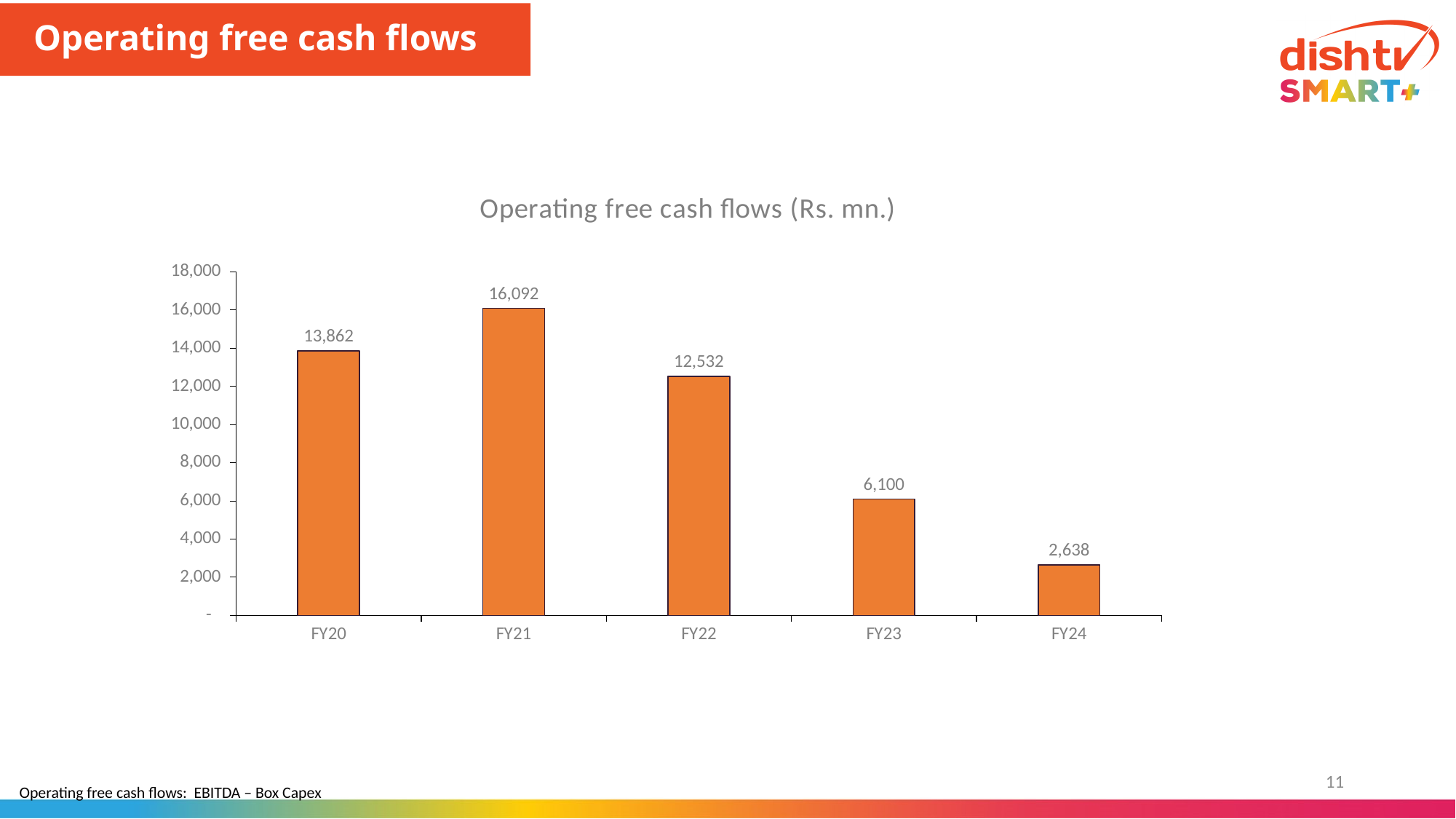
What kind of chart is shown on the slide? Bar chart What is the operating free cash flow for FY22? 12,532 What is the unit given in the chart title? Rs. mn. Which is larger, the operating free cash flow in FY20 or FY22? FY20 Which fiscal year has the lowest operating free cash flow? FY24 What is the operating free cash flow for FY24? 2,638 What is the difference between the operating free cash flow in FY21 and FY20? 2,230 What is the operating free cash flow for FY21? 16,092 Is the value for FY23 greater or less than 8,000? less How many fiscal years are shown on the chart? 5 What is the difference between the operating free cash flow in FY23 and FY24? 3,462 Which fiscal year has the highest operating free cash flow? FY21